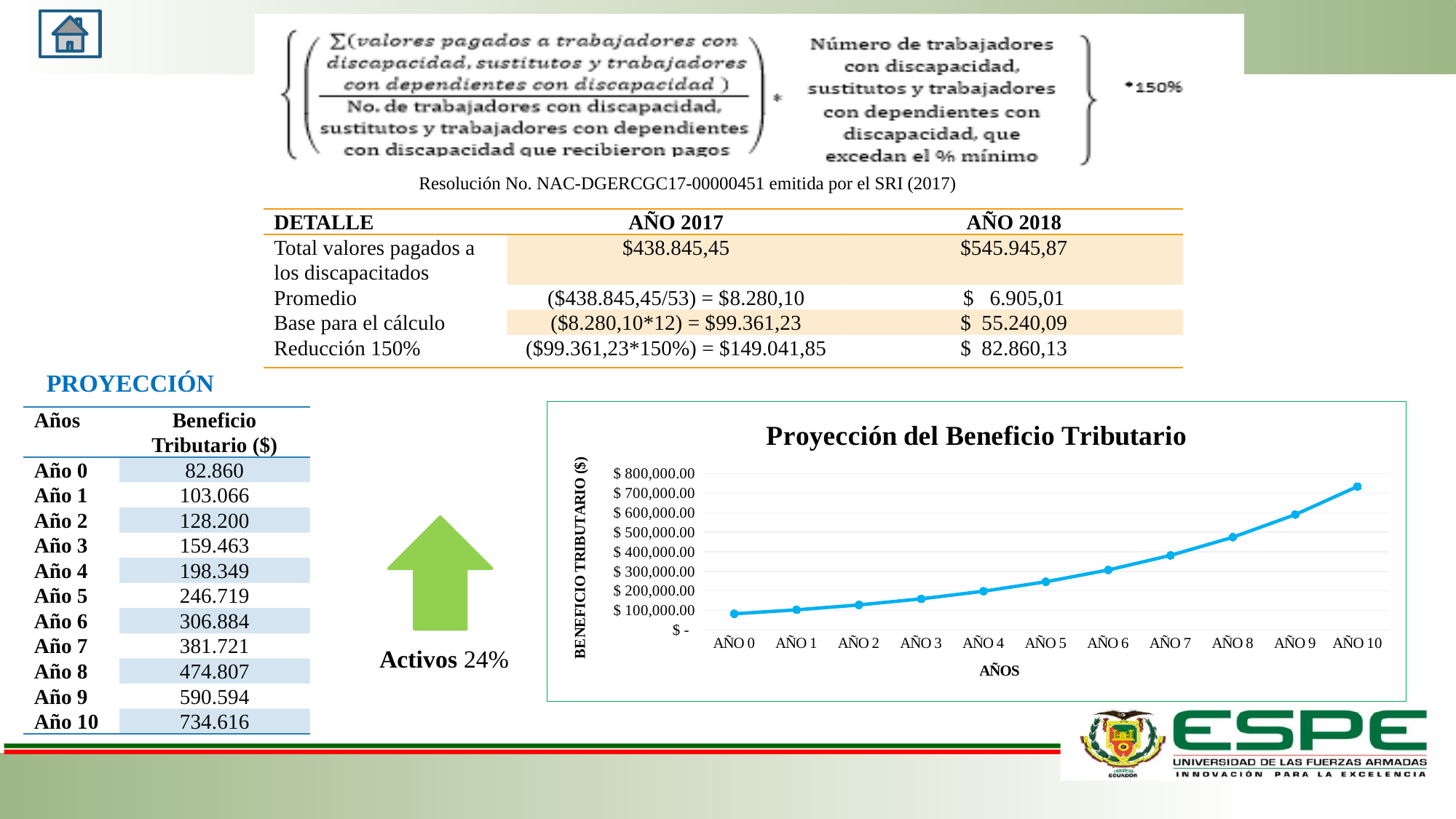
In the chart 'Proyección del Beneficio Tributario', which is larger, the value for AÑO 3 or the value for AÑO 7? AÑO 7 In the chart 'Proyección del Beneficio Tributario', which year has the lowest beneficio tributario? AÑO 0 In the chart 'Proyección del Beneficio Tributario', is the value for AÑO 10 greater or less than $ 600,000.00? greater In the chart 'Proyección del Beneficio Tributario', is the value for AÑO 8 greater or less than $ 400,000.00? greater In the chart 'Proyección del Beneficio Tributario', which year has the highest beneficio tributario? AÑO 10 In the chart 'Proyección del Beneficio Tributario', is the value for AÑO 5 greater or less than $ 200,000.00? greater In the chart 'Proyección del Beneficio Tributario', how many years (points) are plotted along the x axis? 11 In the chart 'Proyección del Beneficio Tributario', do the values rise or fall from AÑO 0 to AÑO 10? rise What is the label of the horizontal axis in the chart 'Proyección del Beneficio Tributario'? AÑOS What kind of chart is 'Proyección del Beneficio Tributario'? line chart What is the label of the vertical axis in the chart 'Proyección del Beneficio Tributario'? BENEFICIO TRIBUTARIO ($)